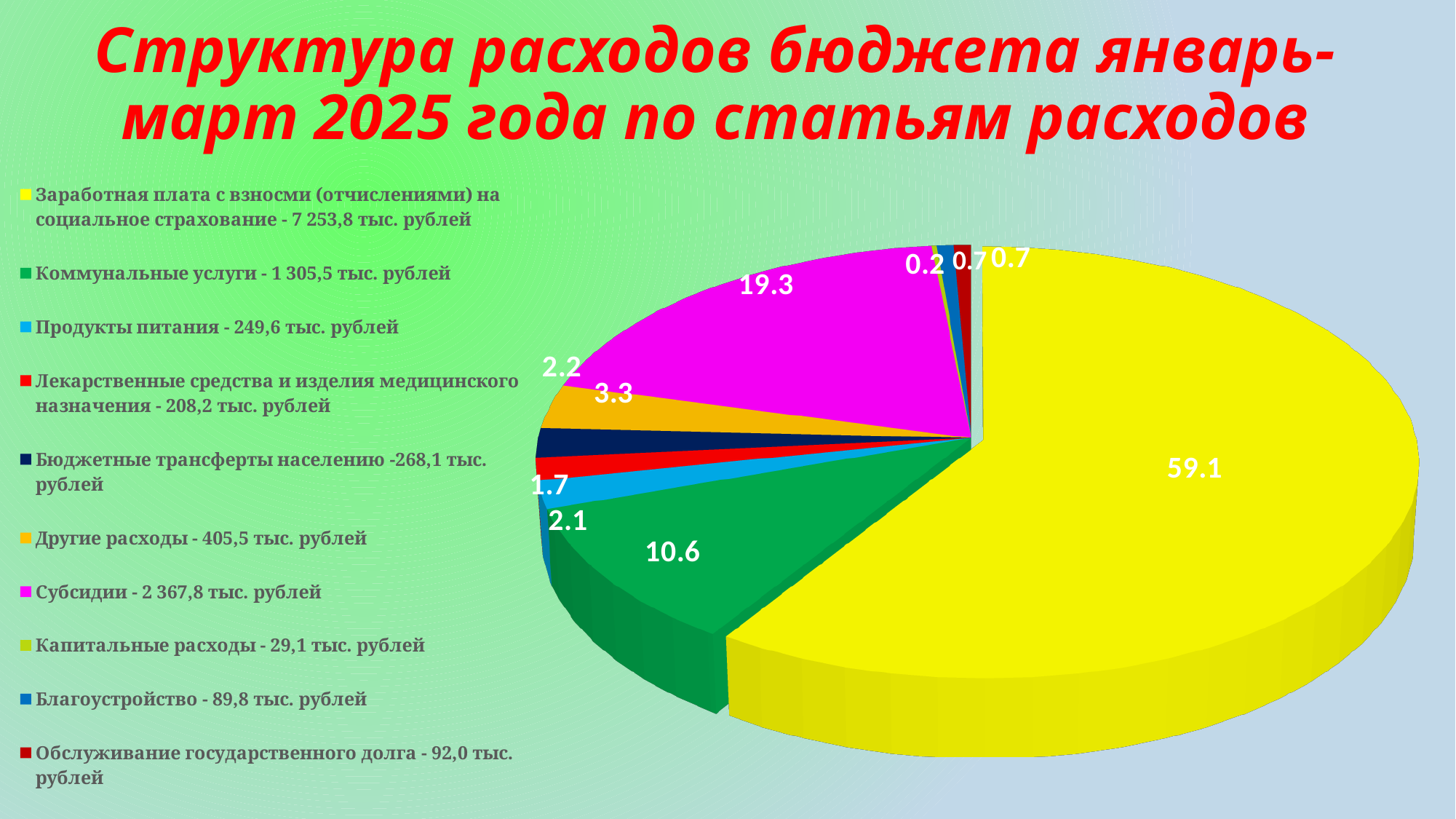
Which category has the largest slice of the pie? Заработная плата с взносами (отчислениями) на социальное страхование What is the difference between the labelled shares for Субсидии and Коммунальные услуги? 8.7 What share of the pie is labelled for Заработная плата с взносами (отчислениями) на социальное страхование? 59.1 What share of the pie is labelled for Коммунальные услуги? 10.6 How many categories does the legend list? 10 What share of the pie is labelled for Другие расходы? 3.3 What kind of chart is shown on the slide? Pie chart According to the legend, what amount is given for Коммунальные услуги? 1 305,5 тыс. рублей Which category has the smallest slice of the pie? Капитальные расходы Which slice is larger: Продукты питания or Лекарственные средства и изделия медицинского назначения? Продукты питания According to the legend, what amount is given for Благоустройство? 89,8 тыс. рублей What share of the pie is labelled for Субсидии? 19.3